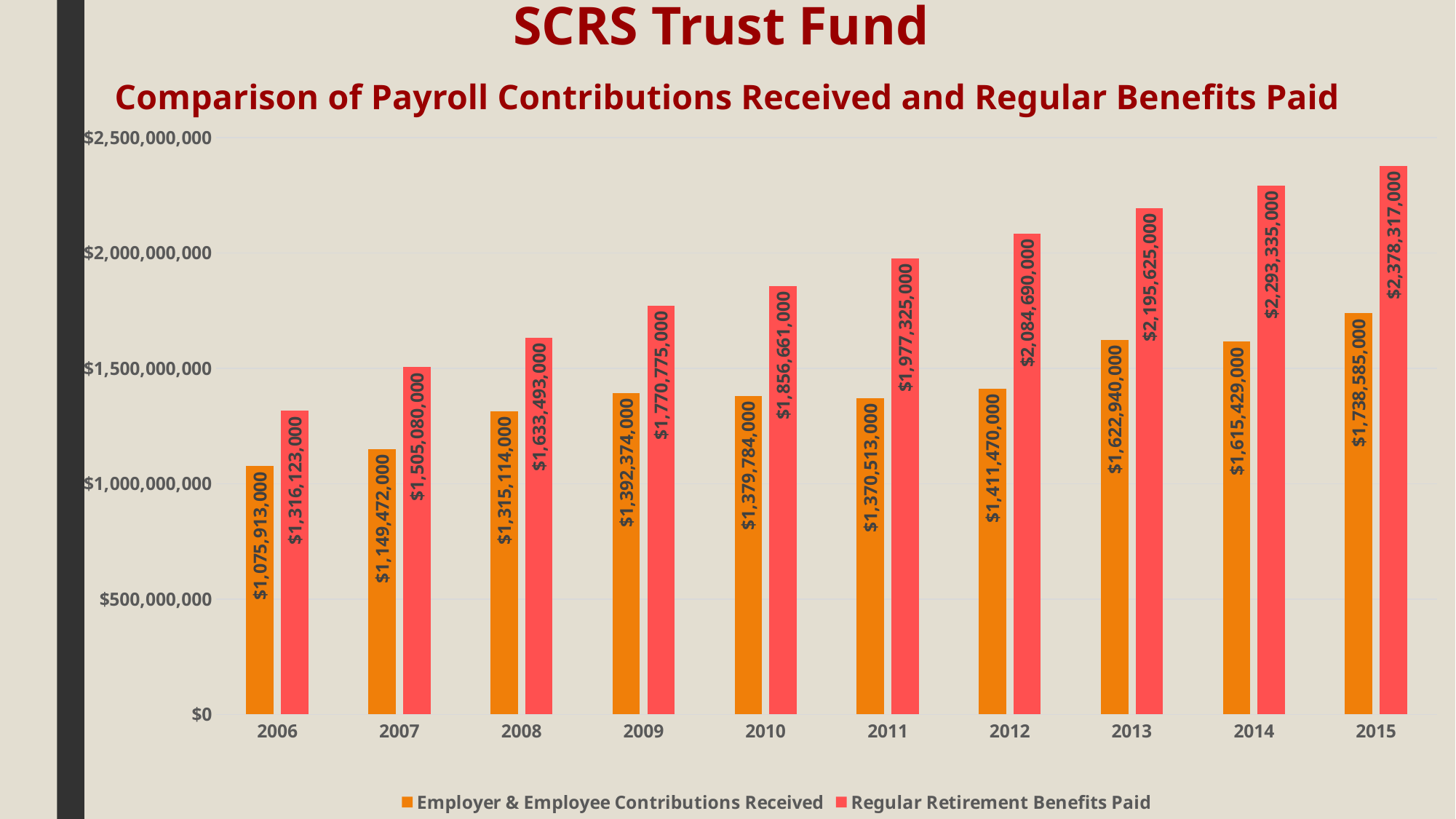
In which year were Regular Retirement Benefits Paid the lowest? 2006 What was the value of Employer & Employee Contributions Received in 2010? $1,379,784,000 In which year were Employer & Employee Contributions Received the highest? 2015 What is the difference between Regular Retirement Benefits Paid and Employer & Employee Contributions Received in 2015? $639,732,000 Which was larger in 2012: Employer & Employee Contributions Received or Regular Retirement Benefits Paid? Regular Retirement Benefits Paid How many years are shown on the x axis? 10 Do Regular Retirement Benefits Paid rise or fall from 2006 to 2015? rise Were Regular Retirement Benefits Paid in 2014 greater or less than $2,000,000,000? greater How many series does the legend list? 2 What was the value of Regular Retirement Benefits Paid in 2013? $2,195,625,000 What was the value of Regular Retirement Benefits Paid in 2006? $1,316,123,000 What kind of chart is shown on the slide? bar chart